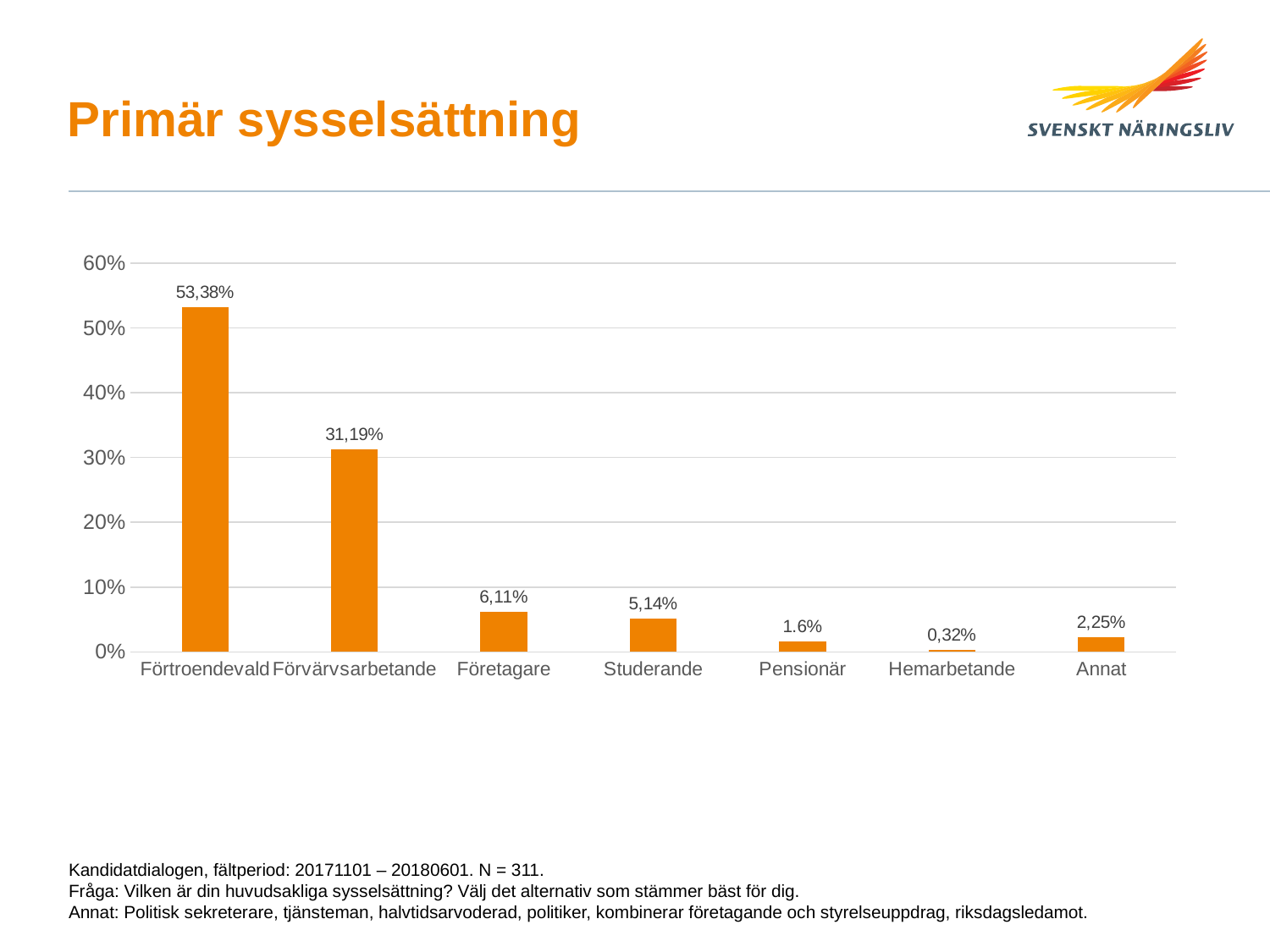
Which is larger, Studerande or Annat? Studerande Which category has the highest value? Förtroendevald Which category has the lowest value? Hemarbetande Is the value for Förvärvsarbetande greater or less than 40%? less How many categories are shown on the x axis? 7 What is the value for Pensionär? 1.6% What kind of chart is shown on the slide? bar chart What is the difference between Förtroendevald and Förvärvsarbetande? 22,19% What is the difference between Företagare and Studerande? 0,97% What is the value for Förvärvsarbetande? 31,19% What is the value for Förtroendevald? 53,38% What is the value for Hemarbetande? 0,32%